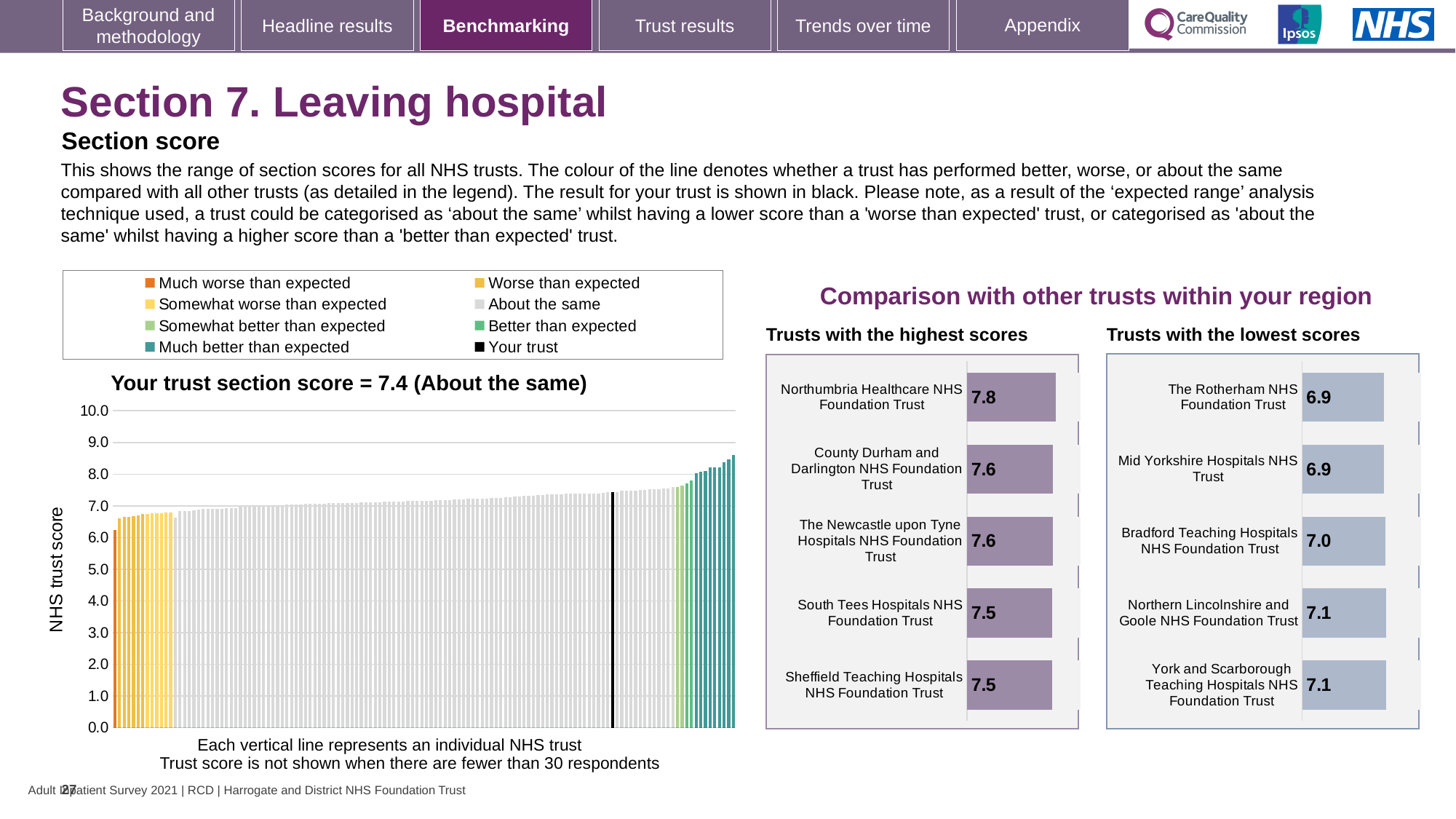
In the 'Trusts with the highest scores' chart, what is the score for South Tees Hospitals NHS Foundation Trust? 7.5 In the 'Trusts with the lowest scores' chart, what is the score for Bradford Teaching Hospitals NHS Foundation Trust? 7.0 In the 'Trusts with the lowest scores' chart, what is the difference between the scores of Northern Lincolnshire and Goole NHS Foundation Trust and Mid Yorkshire Hospitals NHS Trust? 0.2 How many entries does the legend of the main chart on the left list? 8 In the 'Trusts with the lowest scores' chart, what is the score for York and Scarborough Teaching Hospitals NHS Foundation Trust? 7.1 In the main chart on the left, is the value of the lowest-scoring trust greater or less than 7.0? less In the 'Trusts with the highest scores' chart, what is the difference between the scores of Northumbria Healthcare NHS Foundation Trust and Sheffield Teaching Hospitals NHS Foundation Trust? 0.3 In the 'Trusts with the highest scores' chart, what is the score for Northumbria Healthcare NHS Foundation Trust? 7.8 In the 'Trusts with the lowest scores' chart, which is larger: the score for Bradford Teaching Hospitals NHS Foundation Trust or The Rotherham NHS Foundation Trust? Bradford Teaching Hospitals NHS Foundation Trust In the 'Trusts with the highest scores' chart, how many trusts are listed? 5 In the 'Trusts with the highest scores' chart, which trust has the highest score? Northumbria Healthcare NHS Foundation Trust In the main chart on the left, what is the section score for your trust? 7.4